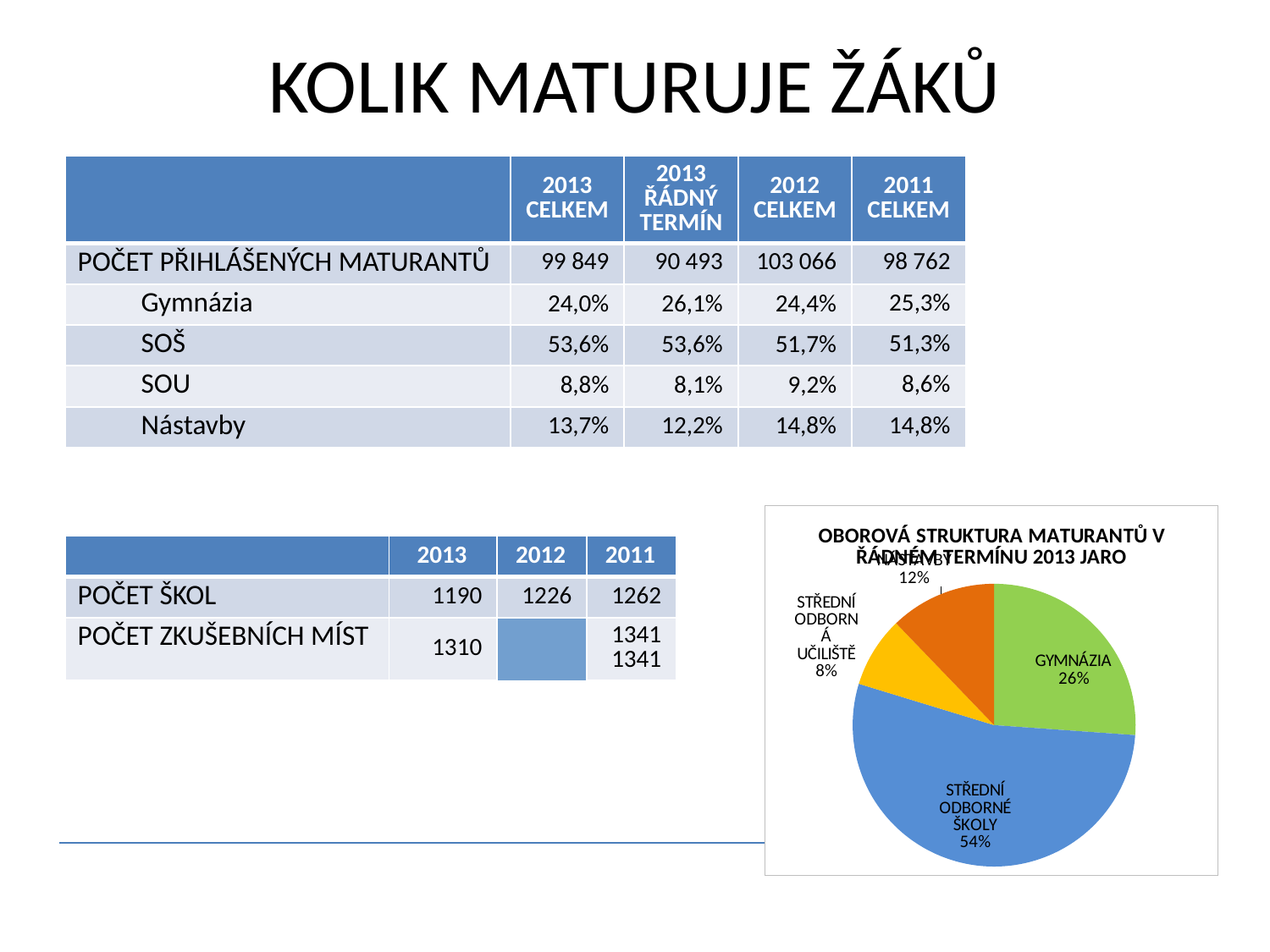
In the pie chart, what share do GYMNÁZIA have? 26% In the pie chart, what share do STŘEDNÍ ODBORNÉ ŠKOLY have? 54% In the pie chart, what is the difference in percentage points between STŘEDNÍ ODBORNÉ ŠKOLY and GYMNÁZIA? 28 In the pie chart, what share do NÁSTAVBY have? 12% Which slice of the pie chart is the smallest? STŘEDNÍ ODBORNÁ UČILIŠTĚ What is the title of the pie chart? OBOROVÁ STRUKTURA MATURANTŮ V ŘÁDNÉM TERMÍNU 2013 JARO Which slice of the pie chart is the largest? STŘEDNÍ ODBORNÉ ŠKOLY How many slices does the pie chart have? 4 What kind of chart is shown on the slide? pie chart In the pie chart, which is larger: GYMNÁZIA or NÁSTAVBY? GYMNÁZIA What colour is the STŘEDNÍ ODBORNÉ ŠKOLY slice in the pie chart? blue